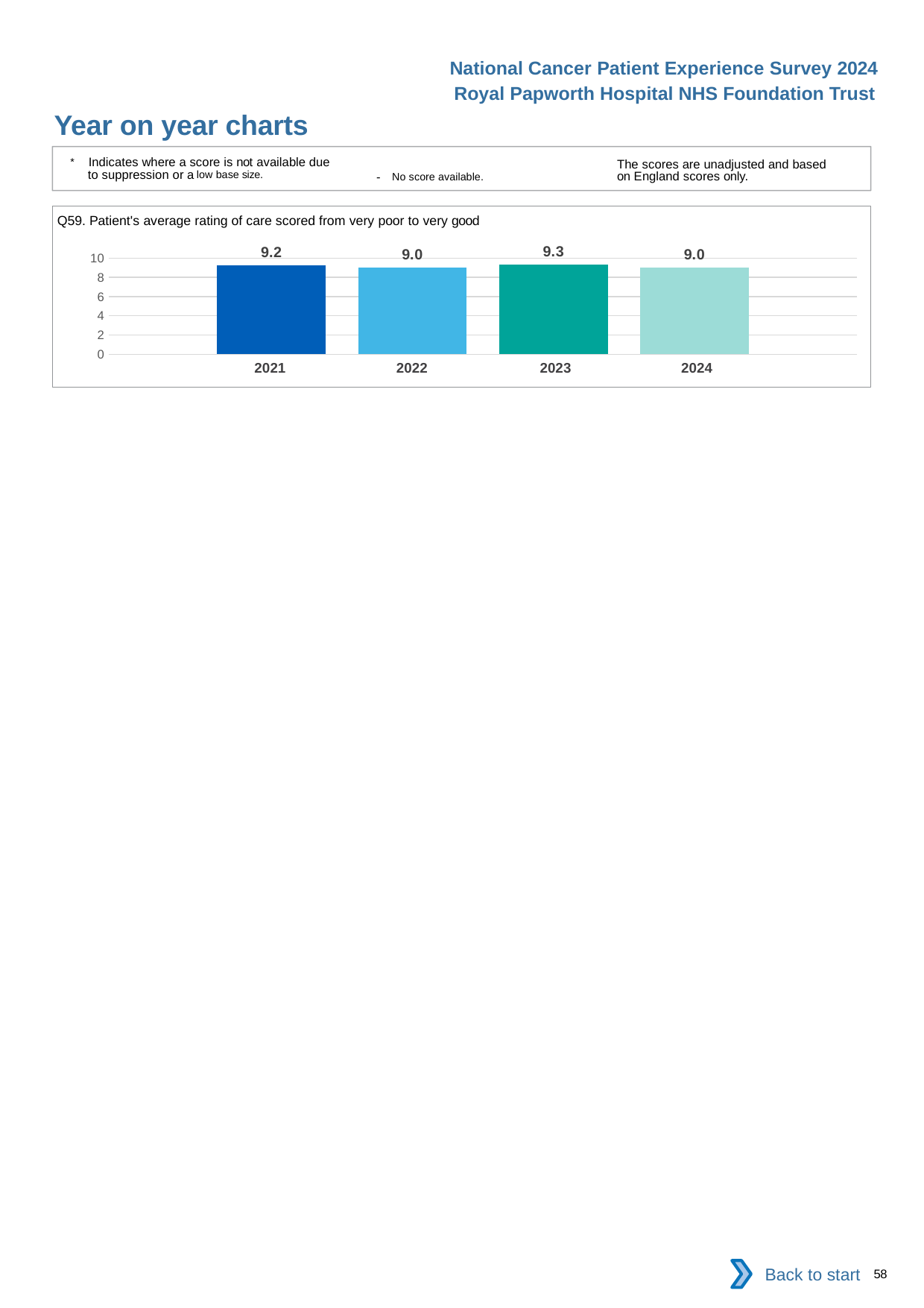
Which is larger, the value for 2021 or the value for 2022? 2021 What is the value for 2024? 9.0 What is the title of the chart? Q59. Patient's average rating of care scored from very poor to very good What kind of chart is shown? Bar chart Which year has the highest value? 2023 Is the value for 2022 greater or less than 8? greater What is the value for 2021? 9.2 What is the difference between the values for 2021 and 2024? 0.2 What is the difference between the values for 2023 and 2022? 0.3 How many years are shown on the chart? 4 What is the value for 2023? 9.3 Does the value rise or fall from 2023 to 2024? Fall